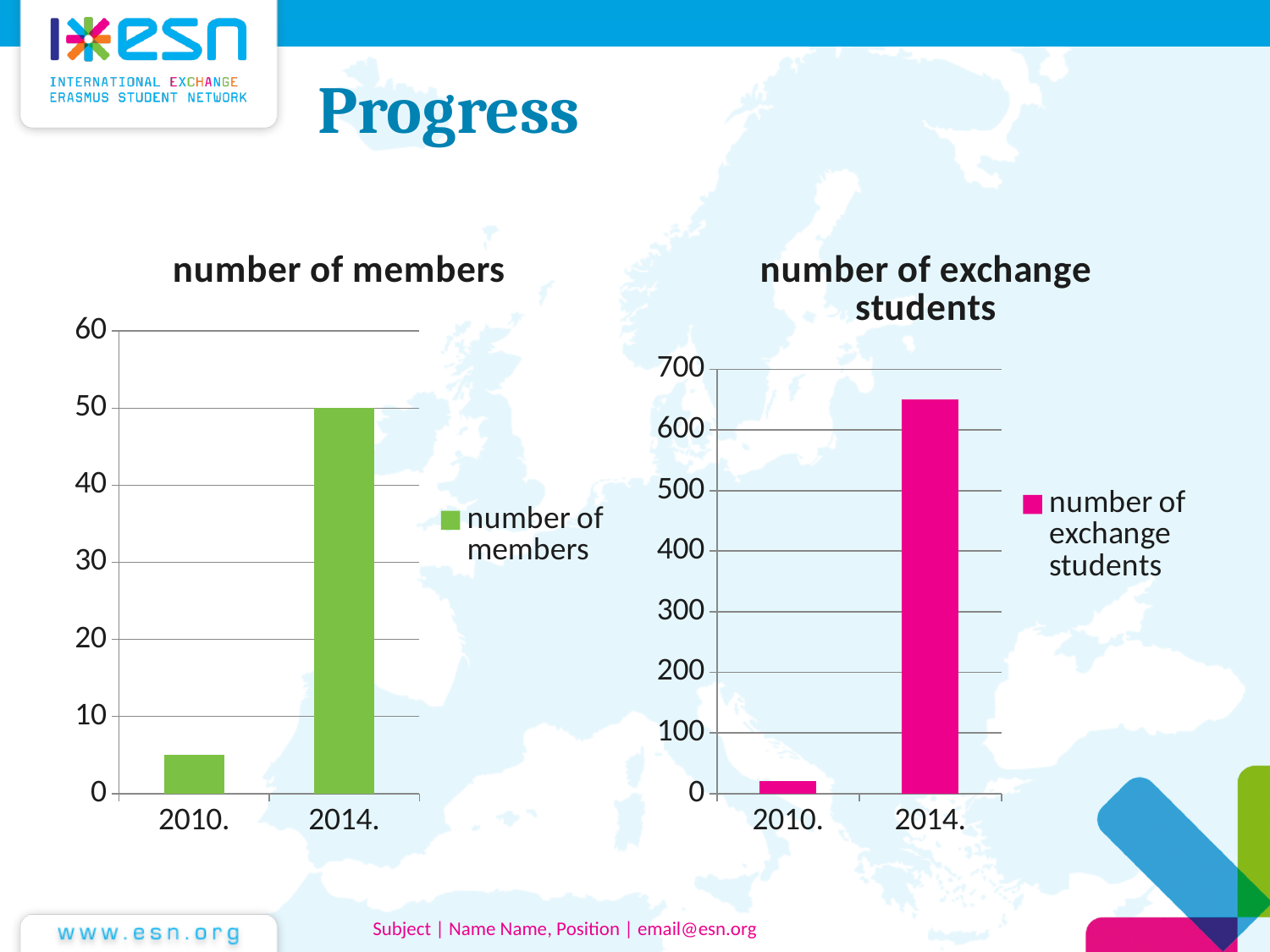
What colour are the bars in the 'number of exchange students' chart? pink In the 'number of members' chart, is the value for 2010 greater or less than 10? less In the 'number of members' chart, what is the value for 2014? 50 In the 'number of members' chart, which year has the higher value? 2014. How many categories are shown on the x axis of the 'number of members' chart? 2 In the 'number of exchange students' chart, is the value for 2014 greater or less than 600? greater In the 'number of exchange students' chart, do the values rise or fall from 2010 to 2014? rise In the 'number of exchange students' chart, which year has the higher value? 2014. In the 'number of members' chart, which year has the lowest value? 2010. In the 'number of exchange students' chart, is the value for 2010 greater or less than 100? less What kind of chart is the 'number of exchange students' chart? bar chart How many series does the legend of the 'number of members' chart list? 1